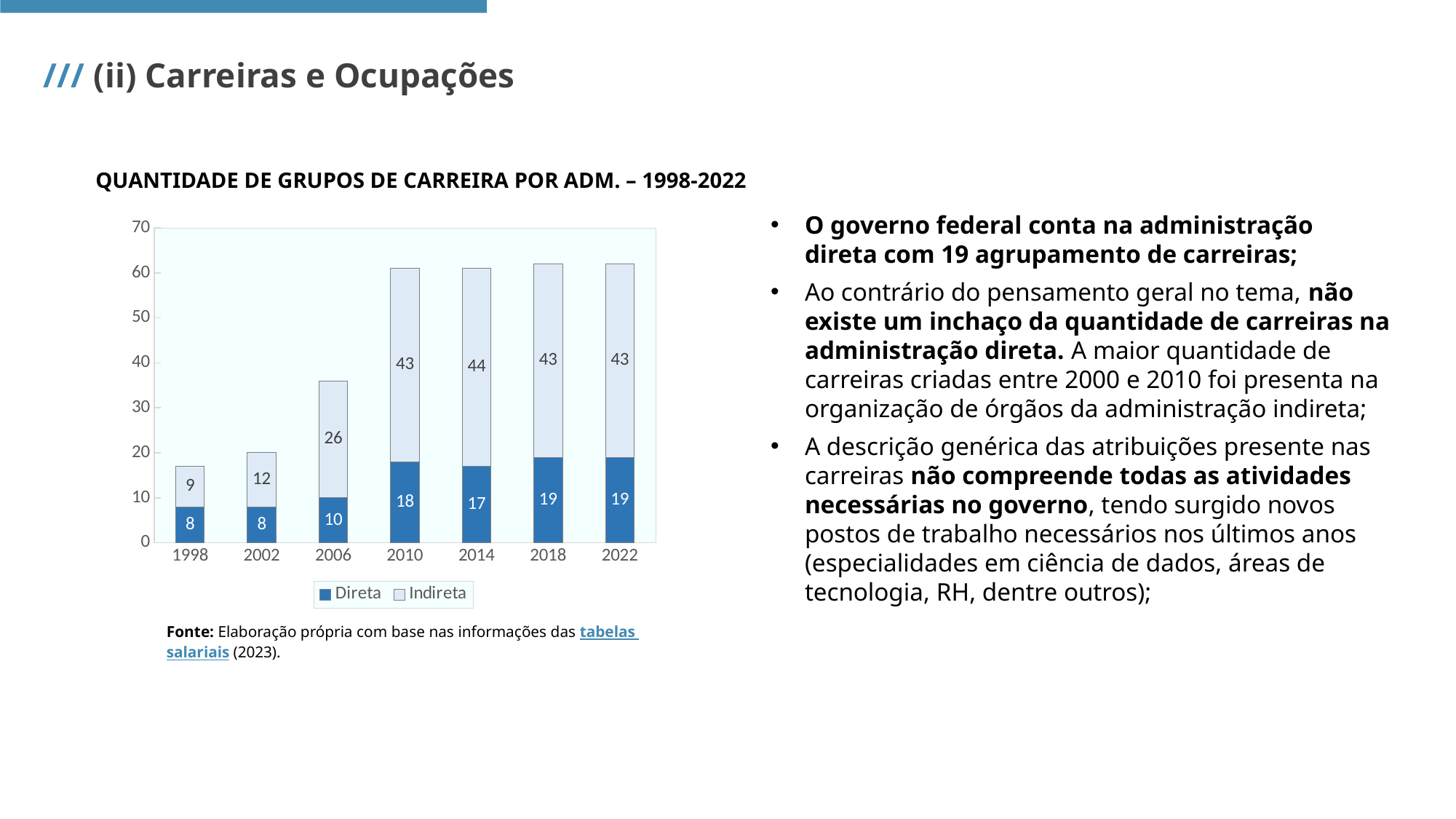
What is the total of the stacked bar for 2022? 62 What is the value for Indireta in 2006? 26 What is the total of the stacked bar for 1998? 17 Which year has the highest Indireta value? 2014 What kind of chart is shown on the slide? Stacked bar chart How many years are shown on the x axis? 7 What is the value for Direta in 2010? 18 Which is larger, the Direta value for 2014 or the Direta value for 2018? 2018 What is the difference between the Indireta values for 2010 and 2006? 17 Which year has the lowest Indireta value? 1998 How many series does the legend list? 2 What is the value for Indireta in 2014? 44